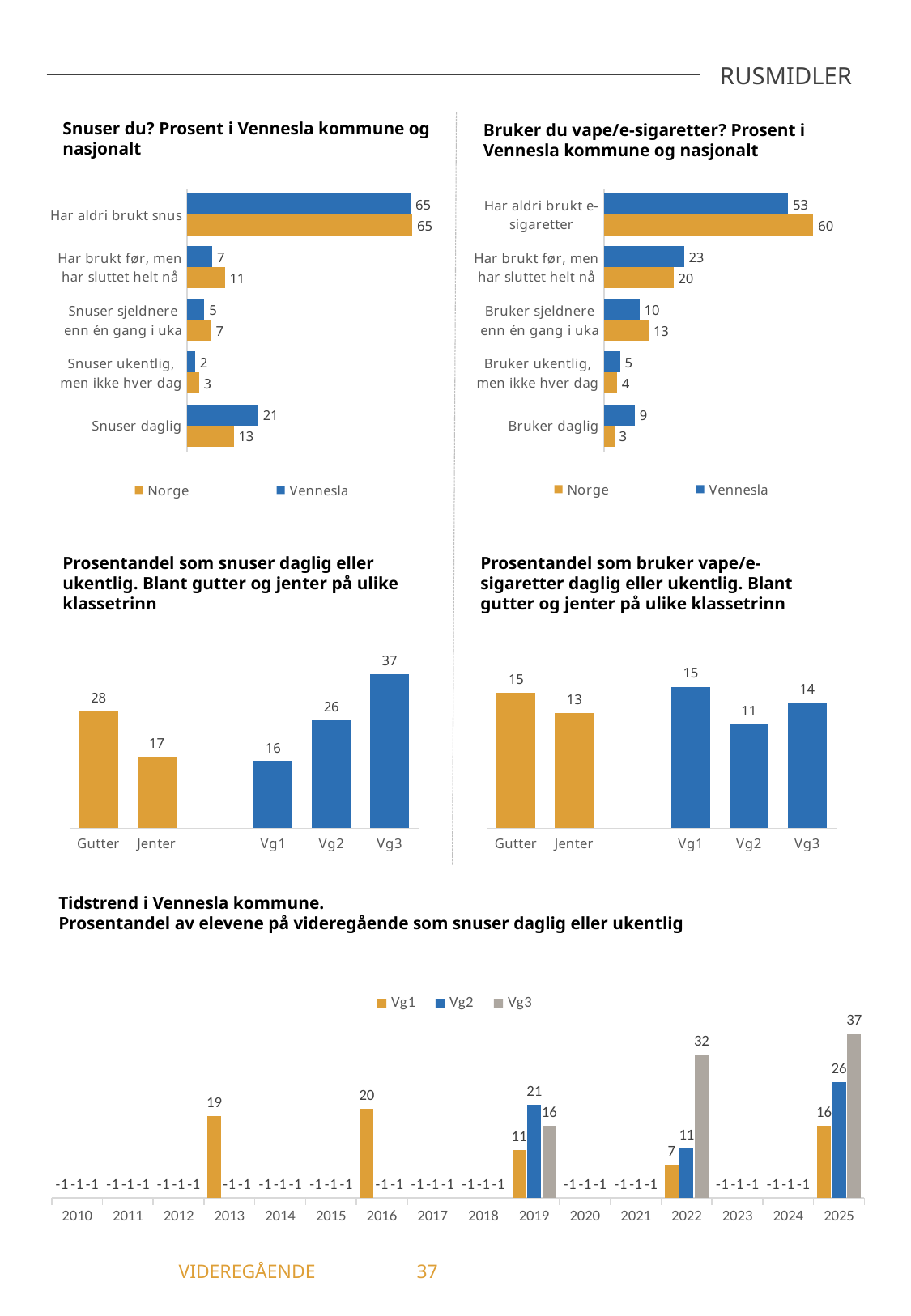
What kind of chart is 'Tidstrend i Vennesla kommune'? Bar chart In the chart 'Prosentandel som bruker vape/e-sigaretter daglig eller ukentlig. Blant gutter og jenter på ulike klassetrinn', what is the value for Jenter? 13 In the chart 'Bruker du vape/e-sigaretter? Prosent i Vennesla kommune og nasjonalt', which is larger for 'Bruker daglig', Norge or Vennesla? Vennesla In the chart 'Tidstrend i Vennesla kommune', what is the Vg3 value for 2022? 32 In the chart 'Snuser du? Prosent i Vennesla kommune og nasjonalt', what is the Vennesla value for 'Snuser daglig'? 21 In the chart 'Tidstrend i Vennesla kommune', how many series does the legend list? 3 In the chart 'Bruker du vape/e-sigaretter? Prosent i Vennesla kommune og nasjonalt', what is the Norge value for 'Har aldri brukt e-sigaretter'? 60 In the chart 'Prosentandel som snuser daglig eller ukentlig. Blant gutter og jenter på ulike klassetrinn', which category has the highest value? Vg3 In the chart 'Prosentandel som snuser daglig eller ukentlig. Blant gutter og jenter på ulike klassetrinn', what is the difference between Gutter and Jenter? 11 How many series does the legend list in the chart 'Bruker du vape/e-sigaretter? Prosent i Vennesla kommune og nasjonalt'? 2 In the chart 'Prosentandel som bruker vape/e-sigaretter daglig eller ukentlig. Blant gutter og jenter på ulike klassetrinn', which category has the lowest value? Vg2 In the chart 'Snuser du? Prosent i Vennesla kommune og nasjonalt', what is the difference between the Norge and Vennesla values for 'Har brukt før, men har sluttet helt nå'? 4